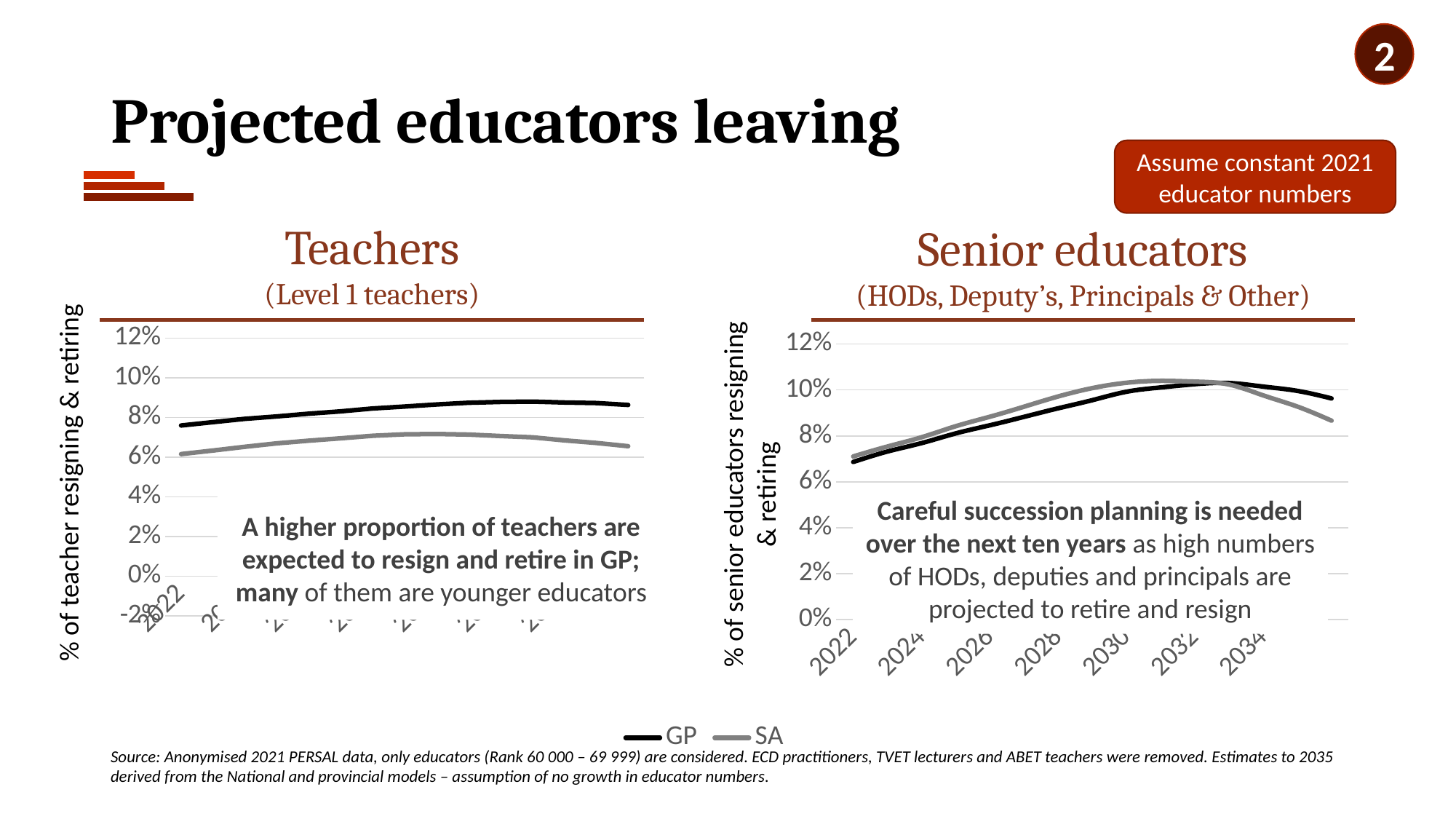
Which two series are shown in the legend? GP and SA How many year labels are shown on the x axis of the Senior educators chart? 7 How many series does the legend list for the charts? 2 In the Senior educators chart, does the SA line rise or fall between 2022 and 2030? rise In the Teachers (Level 1 teachers) chart, which series is higher throughout, GP or SA? GP What kind of chart is the Teachers (Level 1 teachers) chart? line chart In the Senior educators chart, is the GP value in 2022 greater or less than 8%? less In the Senior educators chart, which series is higher in 2034, GP or SA? GP In the Teachers (Level 1 teachers) chart, is the GP value at the start of the series greater or less than 8%? less In the Senior educators chart, is the GP value in 2034 greater or less than 8%? greater What kind of chart is the Senior educators chart? line chart